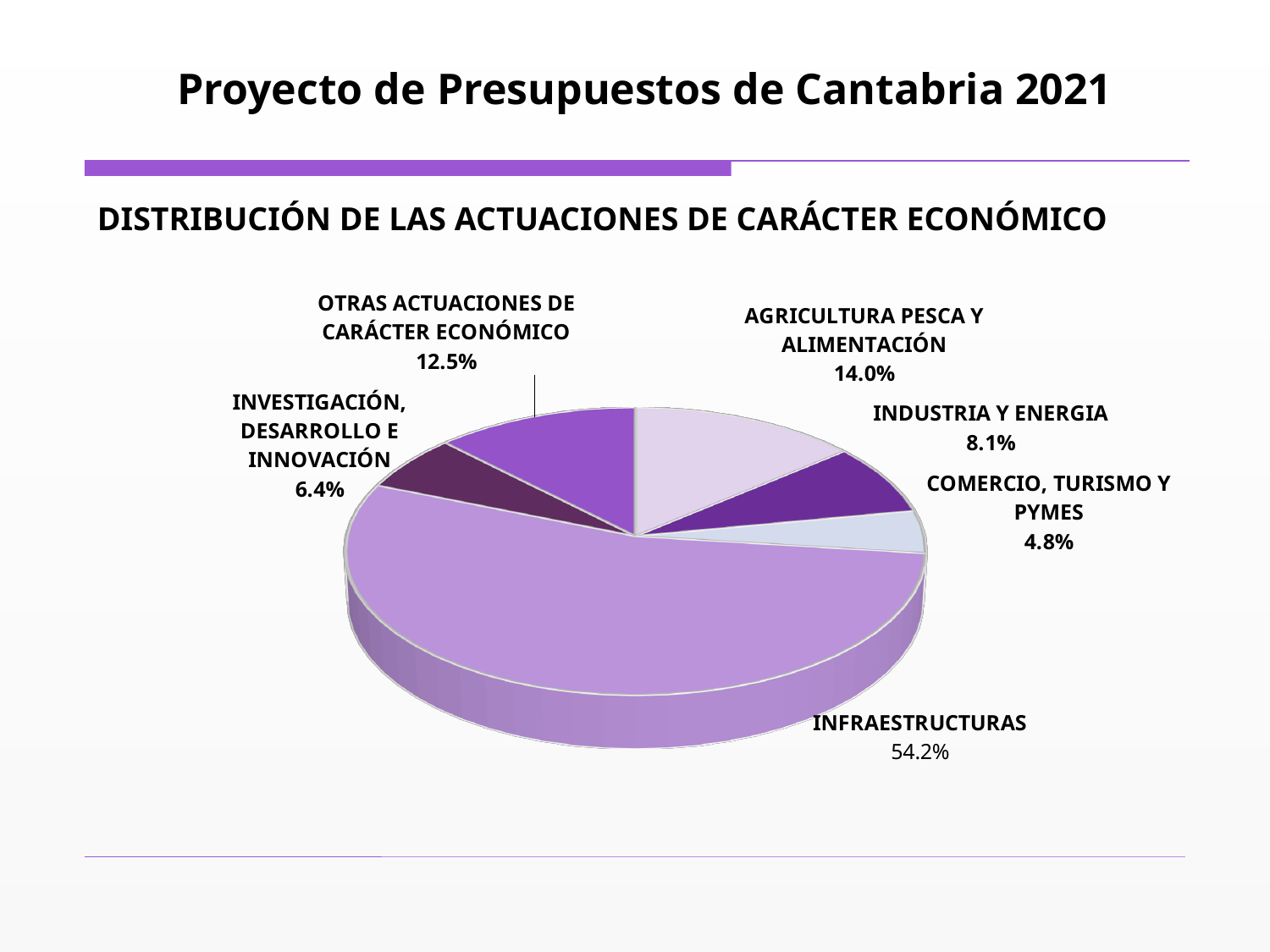
What share of the pie does INFRAESTRUCTURAS represent? 54.2% How many categories are shown in the pie chart? 6 What is the difference between the shares of AGRICULTURA PESCA Y ALIMENTACIÓN and OTRAS ACTUACIONES DE CARÁCTER ECONÓMICO? 1.5% What is the value shown for INDUSTRIA Y ENERGIA? 8.1% What kind of chart is shown on the slide? pie chart What is the title of the chart? DISTRIBUCIÓN DE LAS ACTUACIONES DE CARÁCTER ECONÓMICO What is the value shown for COMERCIO, TURISMO Y PYMES? 4.8% Which category has the smallest slice of the pie? COMERCIO, TURISMO Y PYMES What is the value shown for INVESTIGACIÓN, DESARROLLO E INNOVACIÓN? 6.4% What is the value shown for AGRICULTURA PESCA Y ALIMENTACIÓN? 14.0% Which category has the largest slice of the pie? INFRAESTRUCTURAS Which is larger, the share for INDUSTRIA Y ENERGIA or the share for INVESTIGACIÓN, DESARROLLO E INNOVACIÓN? INDUSTRIA Y ENERGIA